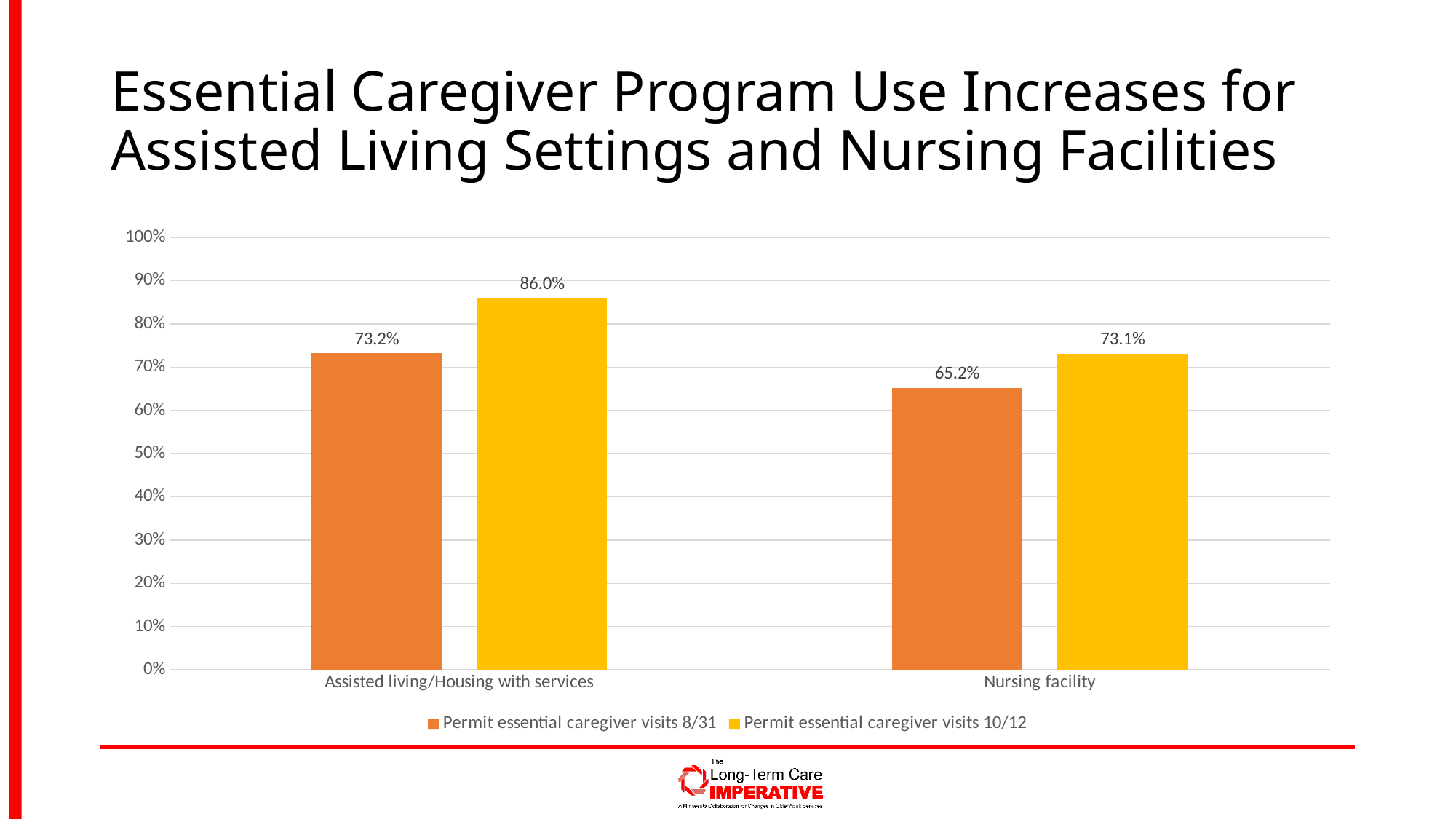
What is the value for Nursing facility in the 'Permit essential caregiver visits 8/31' series? 65.2% Which is larger: the 8/31 value for Assisted living/Housing with services or the 8/31 value for Nursing facility? Assisted living/Housing with services What kind of chart is shown on the slide? Bar chart How many series does the legend list? 2 What is the value for Assisted living/Housing with services in the 'Permit essential caregiver visits 8/31' series? 73.2% What is the difference between the 10/12 and 8/31 values for Assisted living/Housing with services? 12.8% What is the difference between the 10/12 and 8/31 values for Nursing facility? 7.9% What is the value for Assisted living/Housing with services in the 'Permit essential caregiver visits 10/12' series? 86.0% How many categories are shown on the x axis? 2 Which category has the lowest value in the 'Permit essential caregiver visits 8/31' series? Nursing facility What is the value for Nursing facility in the 'Permit essential caregiver visits 10/12' series? 73.1% Which category has the highest value in the 'Permit essential caregiver visits 10/12' series? Assisted living/Housing with services